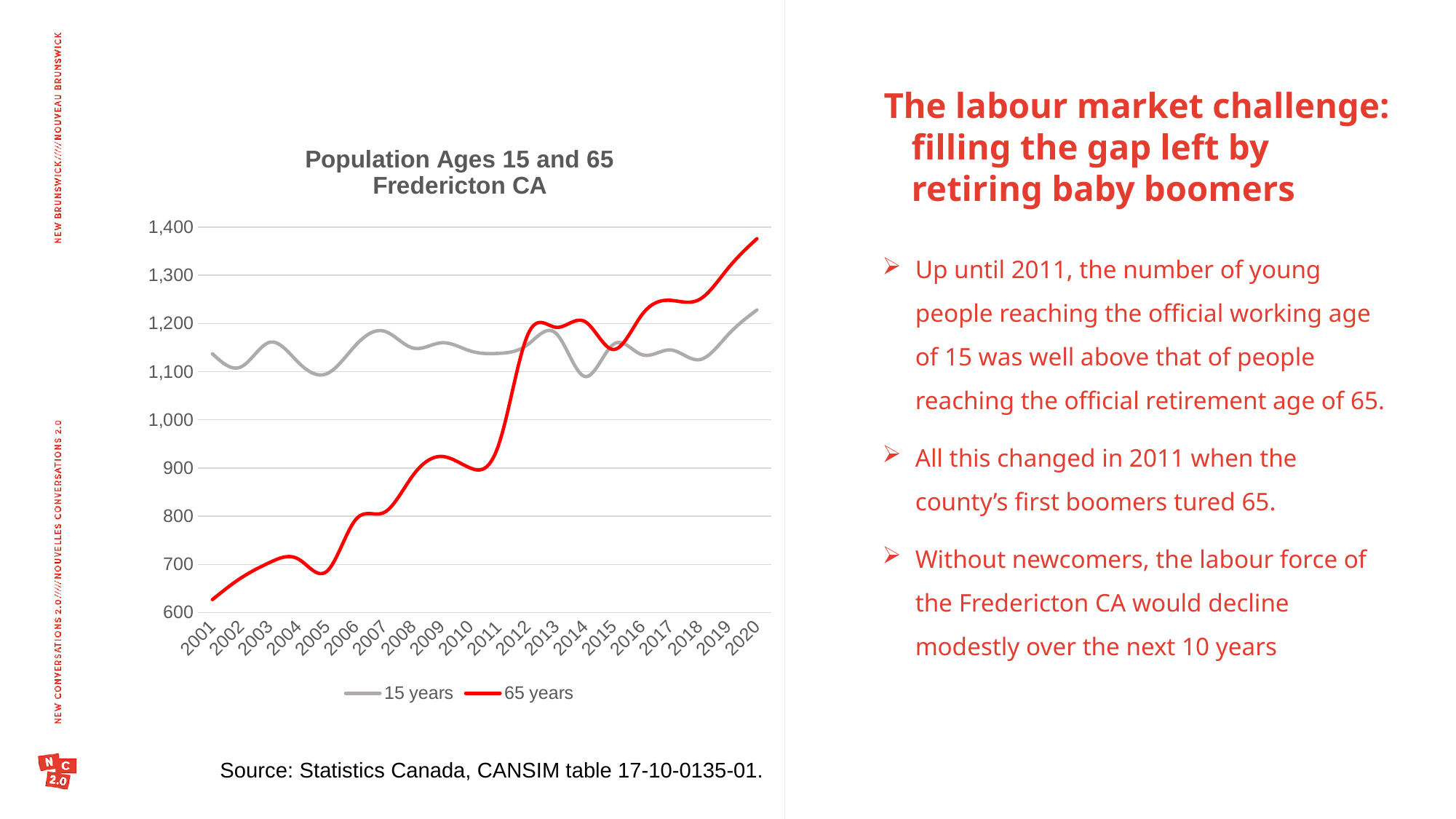
In 2001, which series has the larger value, 15 years or 65 years? 15 years Does the 65 years series generally rise or fall from 2001 to 2020? rise What colour is the line for the 65 years series? red Is the value for 65 years in 2017 greater or less than 1,200? greater Is the value for 15 years in 2001 greater or less than 1,100? greater Is the value for 65 years in 2020 greater or less than 1,300? greater How many series does the legend list? 2 What kind of chart is shown on the slide? line chart How many years are plotted along the x axis? 20 In 2020, which series has the larger value, 15 years or 65 years? 65 years What is the title of the chart? Population Ages 15 and 65 Fredericton CA